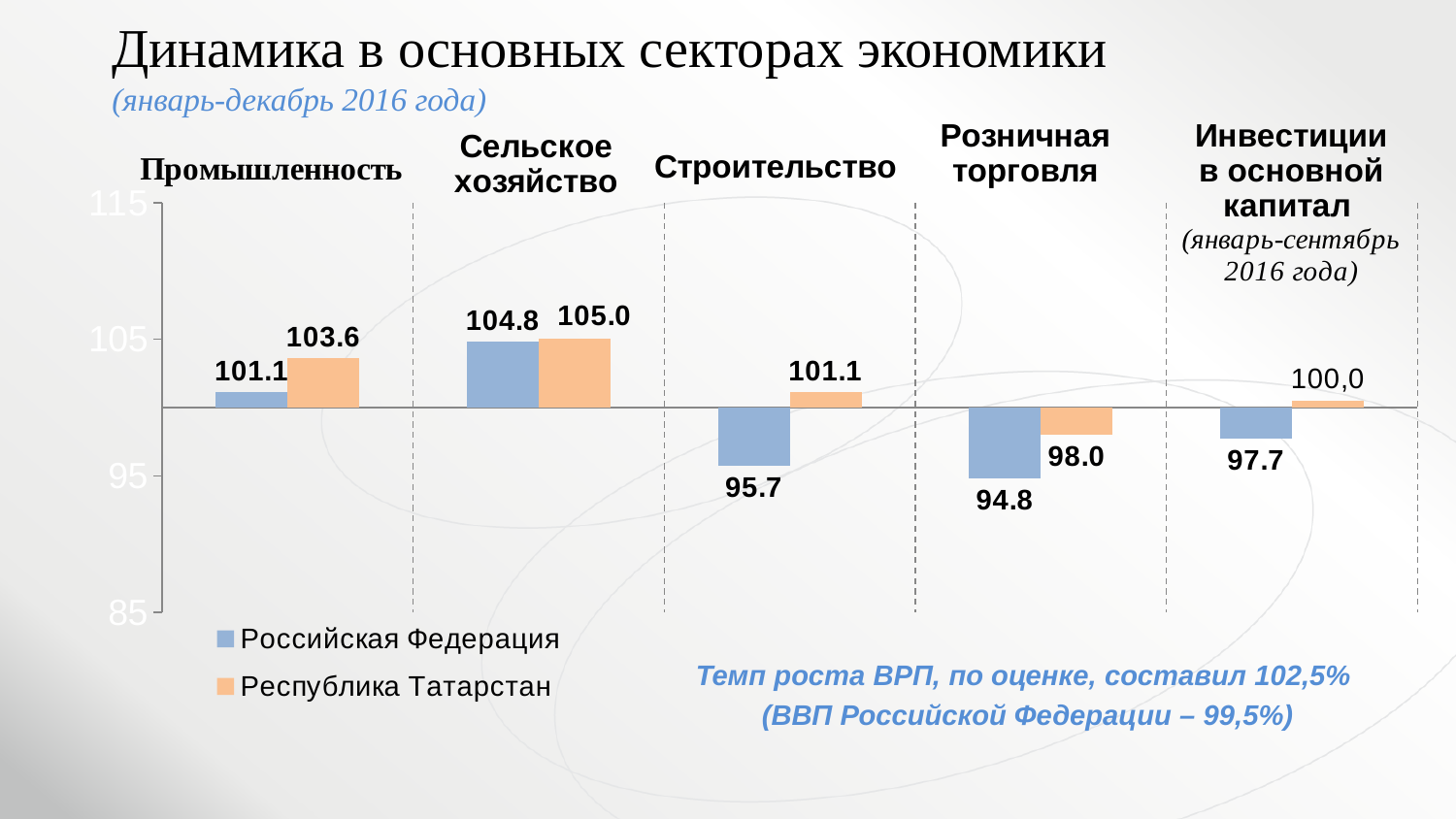
What is the value for Российская Федерация in Строительство? 95.7 What kind of chart is shown on the slide? bar chart How many series does the legend list? 2 Which category has the highest value for Республика Татарстан? Сельское хозяйство What is the value for Республика Татарстан in Промышленность? 103.6 What is the value for Республика Татарстан in Розничная торговля? 98.0 What is the difference between the Республика Татарстан and Российская Федерация values in Строительство? 5.4 How many categories (sectors) are shown on the chart? 5 Is the value for Российская Федерация in Сельское хозяйство greater or less than 105? less Which category has the lowest value for Российская Федерация? Розничная торговля Which is larger in Розничная торговля: the value for Российская Федерация or for Республика Татарстан? Республика Татарстан What is the value for Российская Федерация in Инвестиции в основной капитал? 97.7